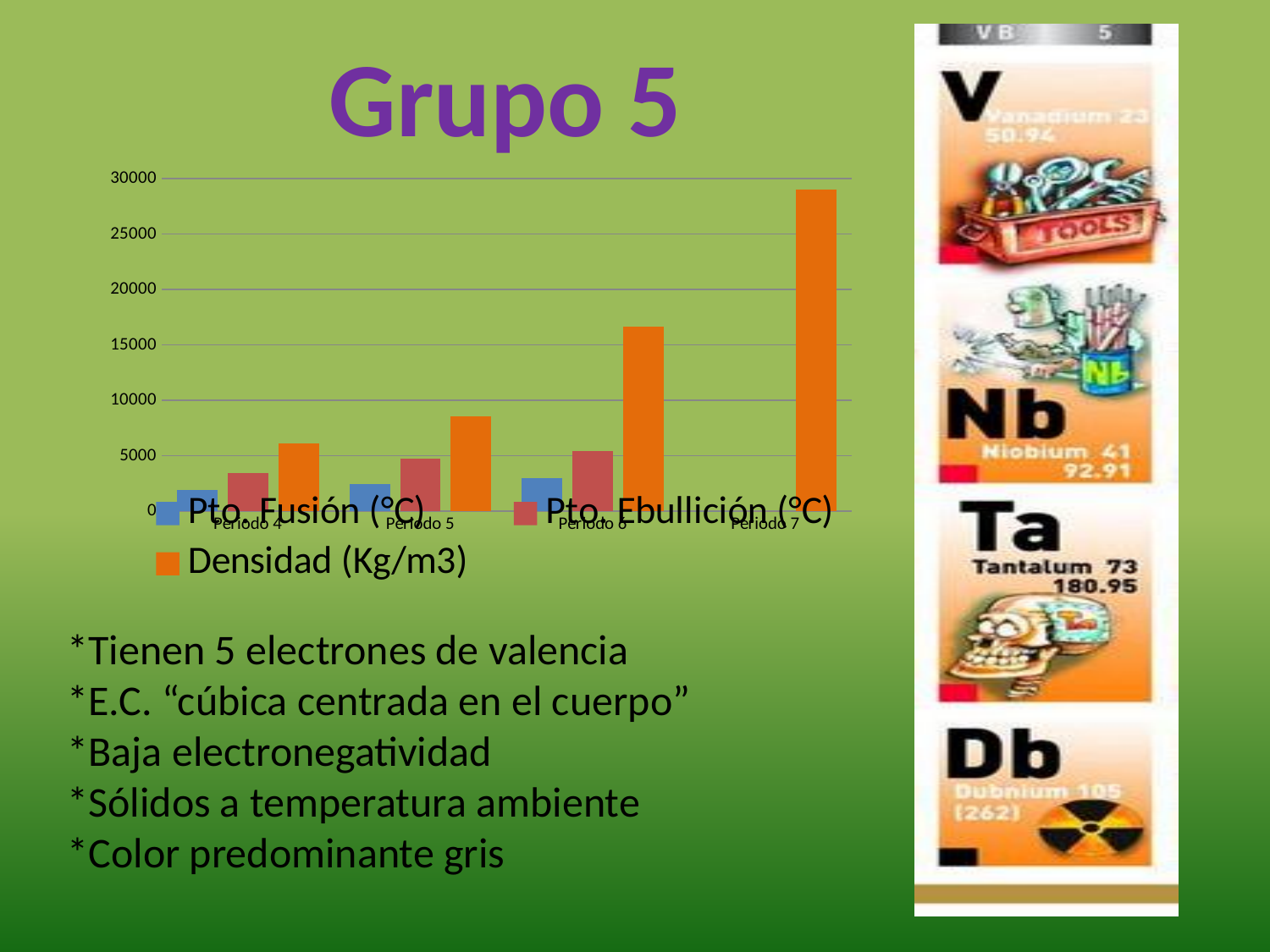
Does the Densidad (Kg/m3) series rise or fall from Periodo 4 to Periodo 7? rise Which is larger, the Densidad (Kg/m3) value for Periodo 6 or for Periodo 5? Periodo 6 What kind of chart is shown on the slide? bar chart Is the Pto. Ebullición (°C) value for Periodo 4 greater or less than 5000? less How many period categories are shown on the x axis of the chart? 4 How many series does the chart legend list? 3 Is the Densidad (Kg/m3) value for Periodo 5 greater or less than 10000? less Which period has the lowest Densidad (Kg/m3) value? Periodo 4 Which colour represents the Densidad (Kg/m3) series in the chart legend? orange Which period has the highest Densidad (Kg/m3) value? Periodo 7 Is the Densidad (Kg/m3) value for Periodo 7 greater or less than 25000? greater